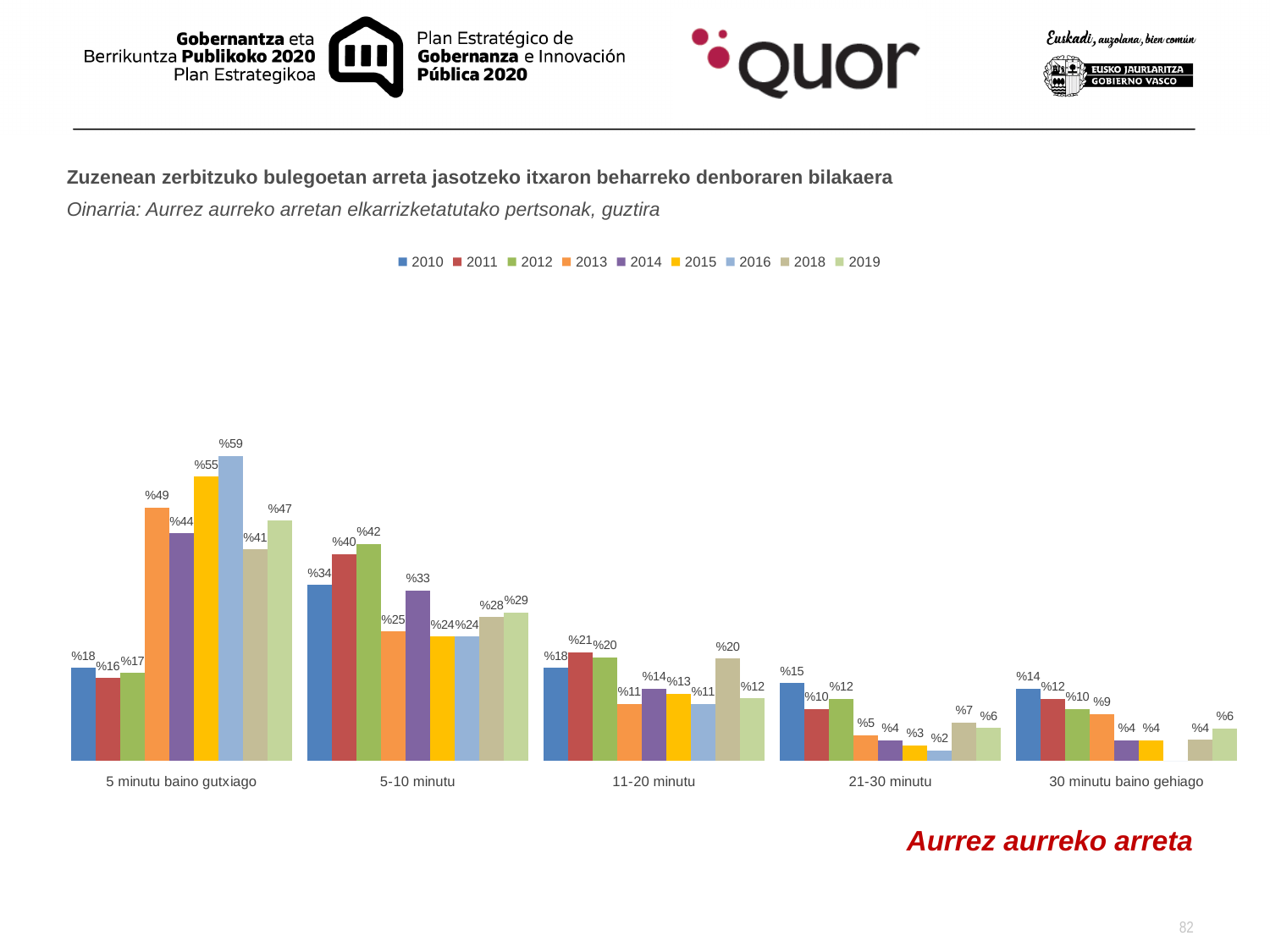
In the '5-10 minutu' category, which is larger: the value for 2012 or the value for 2014? 2012 What is the difference between the 2016 and 2010 values in the '5 minutu baino gutxiago' category? 41 What is the value for 2010 in the '30 minutu baino gehiago' category? %14 Which year has the highest value in the '5 minutu baino gutxiago' category? 2016 Which year is shown in yellow in the legend? 2015 What is the value for 2018 in the '11-20 minutu' category? %20 How many categories are shown on the x axis? 5 What kind of chart is shown on the slide? bar chart What is the value for 2016 in the '5 minutu baino gutxiago' category? %59 What is the value for 2019 in the '5-10 minutu' category? %29 How many series does the legend list? 9 Which year has the lowest value in the '21-30 minutu' category? 2016